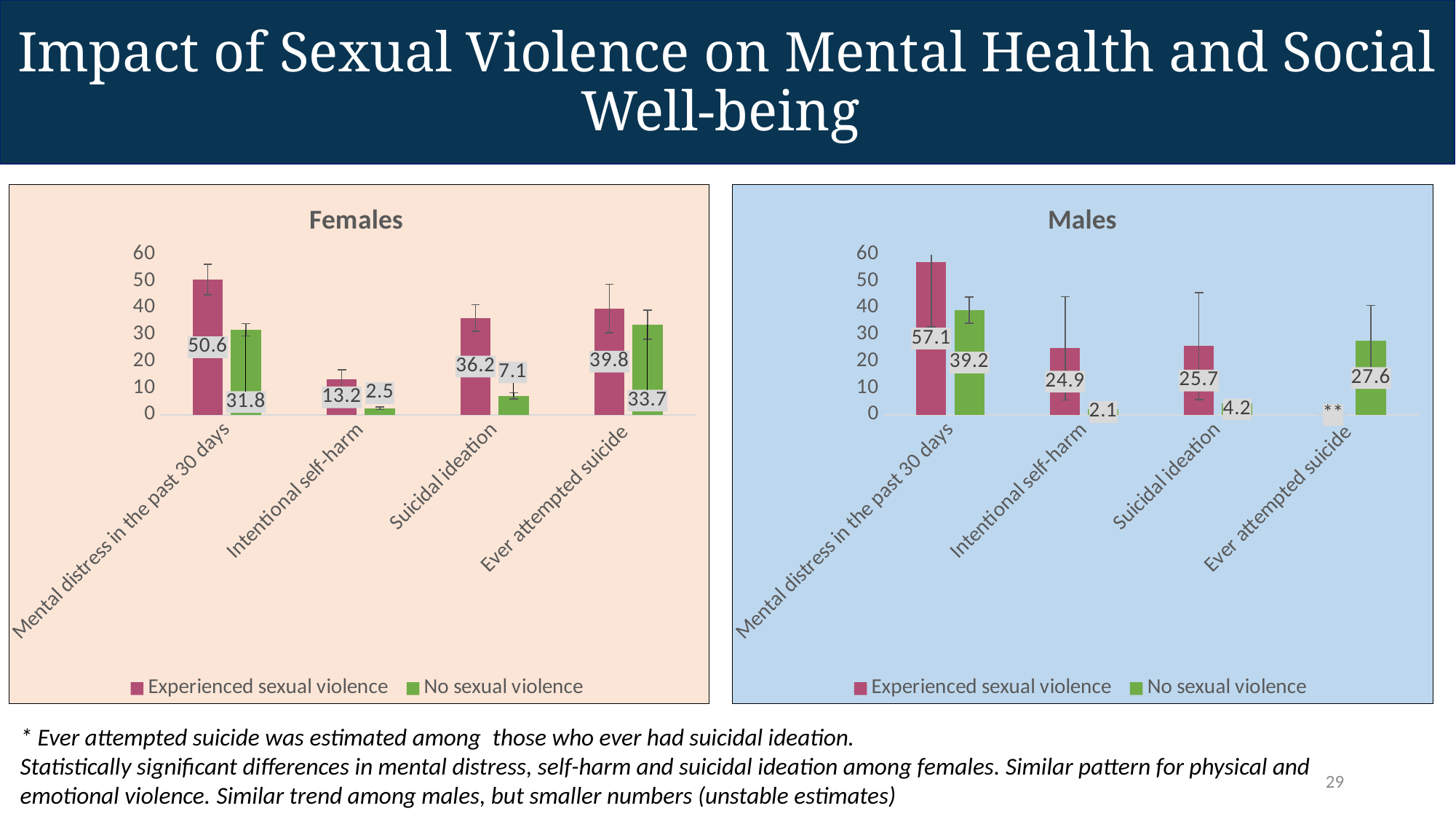
In the Males chart, what is the value for Ever attempted suicide among those with no sexual violence? 27.6 How many categories are shown on the x axis of the Males chart? 4 In the Females chart, which category has the lowest value for the No sexual violence series? Intentional self-harm In the Females chart, what is the difference between the Experienced sexual violence and No sexual violence values for Suicidal ideation? 29.1 In the Females chart, what is the value for Suicidal ideation among those with no sexual violence? 7.1 How many series does the legend of the Females chart list? 2 In the Males chart, what is the value for Mental distress in the past 30 days among those who experienced sexual violence? 57.1 In the Females chart, which is larger for Ever attempted suicide: the Experienced sexual violence value or the No sexual violence value? Experienced sexual violence In the Females chart, what is the value for Mental distress in the past 30 days among those who experienced sexual violence? 50.6 In the Males chart, what is the difference between the Experienced sexual violence and No sexual violence values for Mental distress in the past 30 days? 17.9 In the Males chart, which category has the highest value for the Experienced sexual violence series? Mental distress in the past 30 days What type of chart is the Females chart? Bar chart